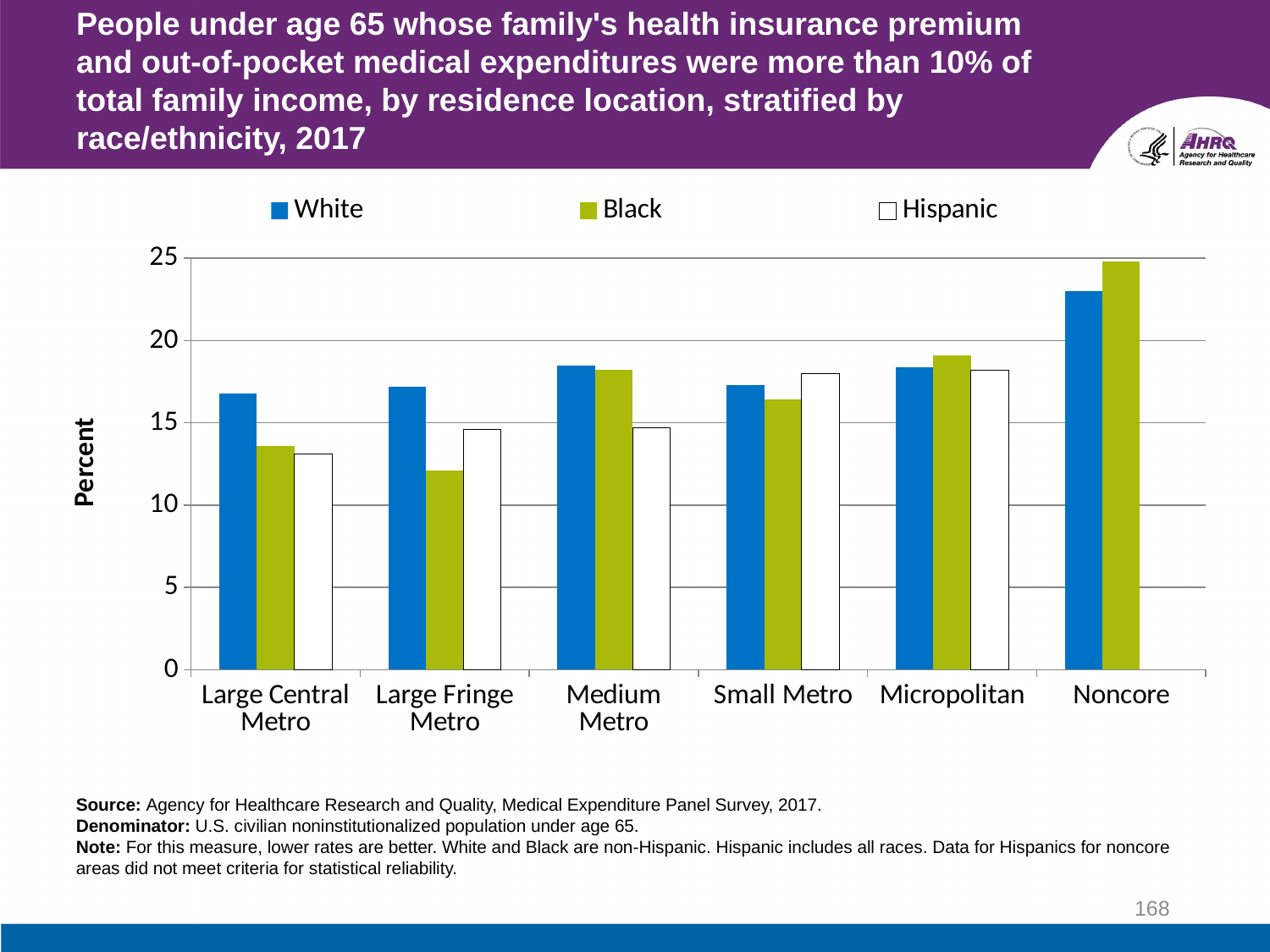
In Noncore, which is larger, the value for Black or the value for White? Black Which residence location has the highest value for White? Noncore Is the value for Black in Large Fringe Metro greater or less than 15? less Is the value for White in Noncore greater or less than 20? greater How many residence location categories are shown on the x axis? 6 Is the value for Hispanic in Small Metro greater or less than 15? greater Which residence location has the highest value for Black? Noncore In Large Central Metro, which is larger, the value for White or the value for Black? White What kind of chart is shown on the slide? bar chart Which residence location has no Hispanic bar plotted? Noncore Which residence location has the lowest value for Black? Large Fringe Metro How many series does the legend list? 3